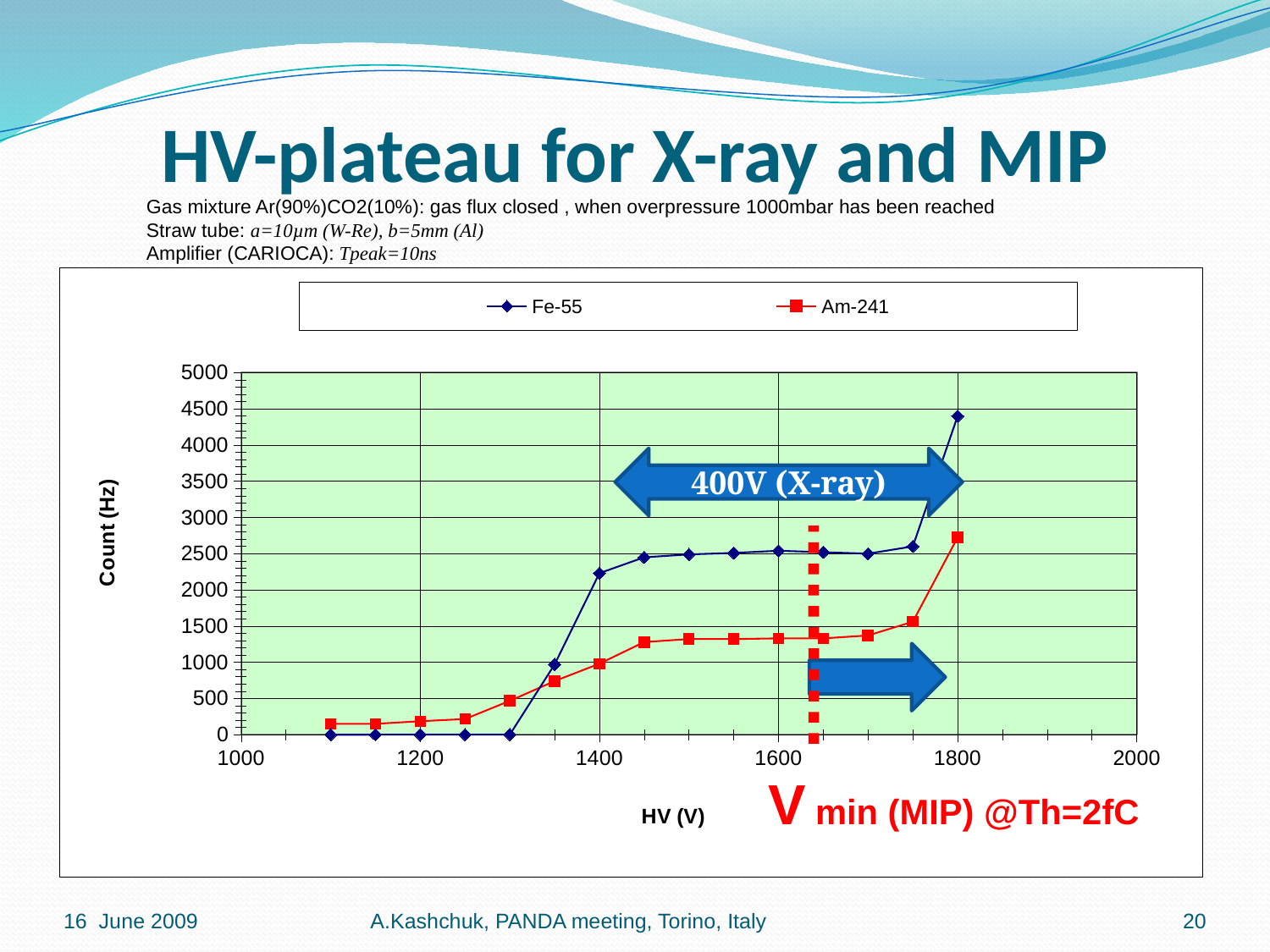
Is the Fe-55 count at HV = 1500 V greater or less than 2000? greater At HV = 1600 V, which series has the higher count, Fe-55 or Am-241? Fe-55 What is the label of the vertical axis? Count (Hz) Is the Am-241 count at HV = 1100 V greater or less than 500? less What kind of chart is shown on the slide? line chart Do the Fe-55 counts generally rise or fall as HV increases from 1300 V to 1800 V? rise Which series reaches the highest count on the chart? Fe-55 Is the Am-241 count at HV = 1500 V greater or less than 1500? less How many series does the legend list? 2 What is the title of the slide's chart? HV-plateau for X-ray and MIP